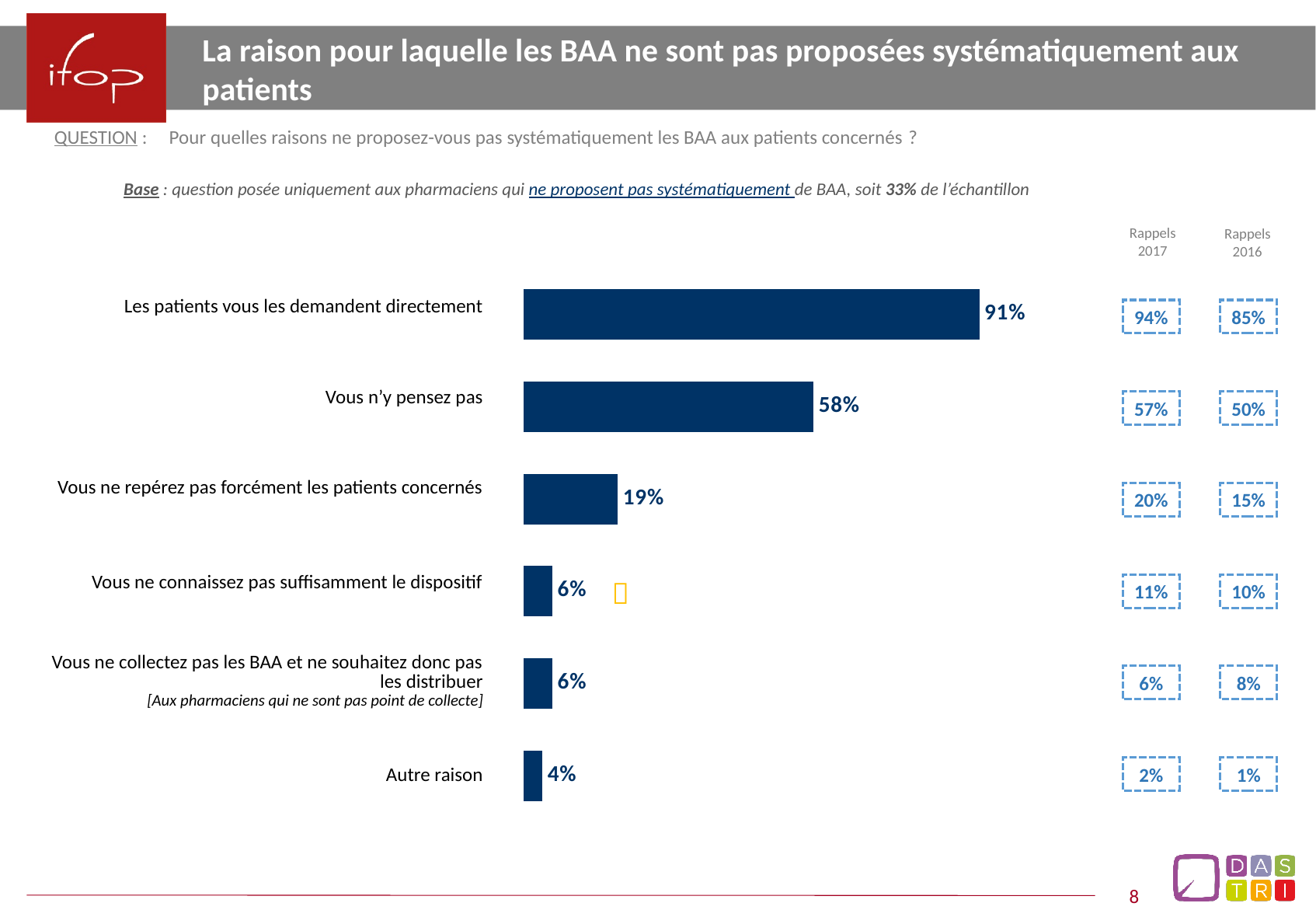
Which reason has the lowest value in the bar chart? Autre raison What kind of chart is shown on the slide? bar chart Which is larger: the value for "Vous n'y pensez pas" or the value for "Vous ne repérez pas forcément les patients concernés"? Vous n'y pensez pas What is the value for "Les patients vous les demandent directement"? 91% What is the value for "Autre raison"? 4% What is the "Rappels 2016" value shown for "Vous n'y pensez pas"? 50% What is the "Rappels 2017" value shown for "Les patients vous les demandent directement"? 94% What is the difference between the values for "Les patients vous les demandent directement" and "Vous n'y pensez pas"? 33% How many categories (reasons) are plotted in the bar chart? 6 What is the value for "Vous ne repérez pas forcément les patients concernés"? 19% What is the value for "Vous n'y pensez pas"? 58% Which reason has the highest value in the bar chart? Les patients vous les demandent directement